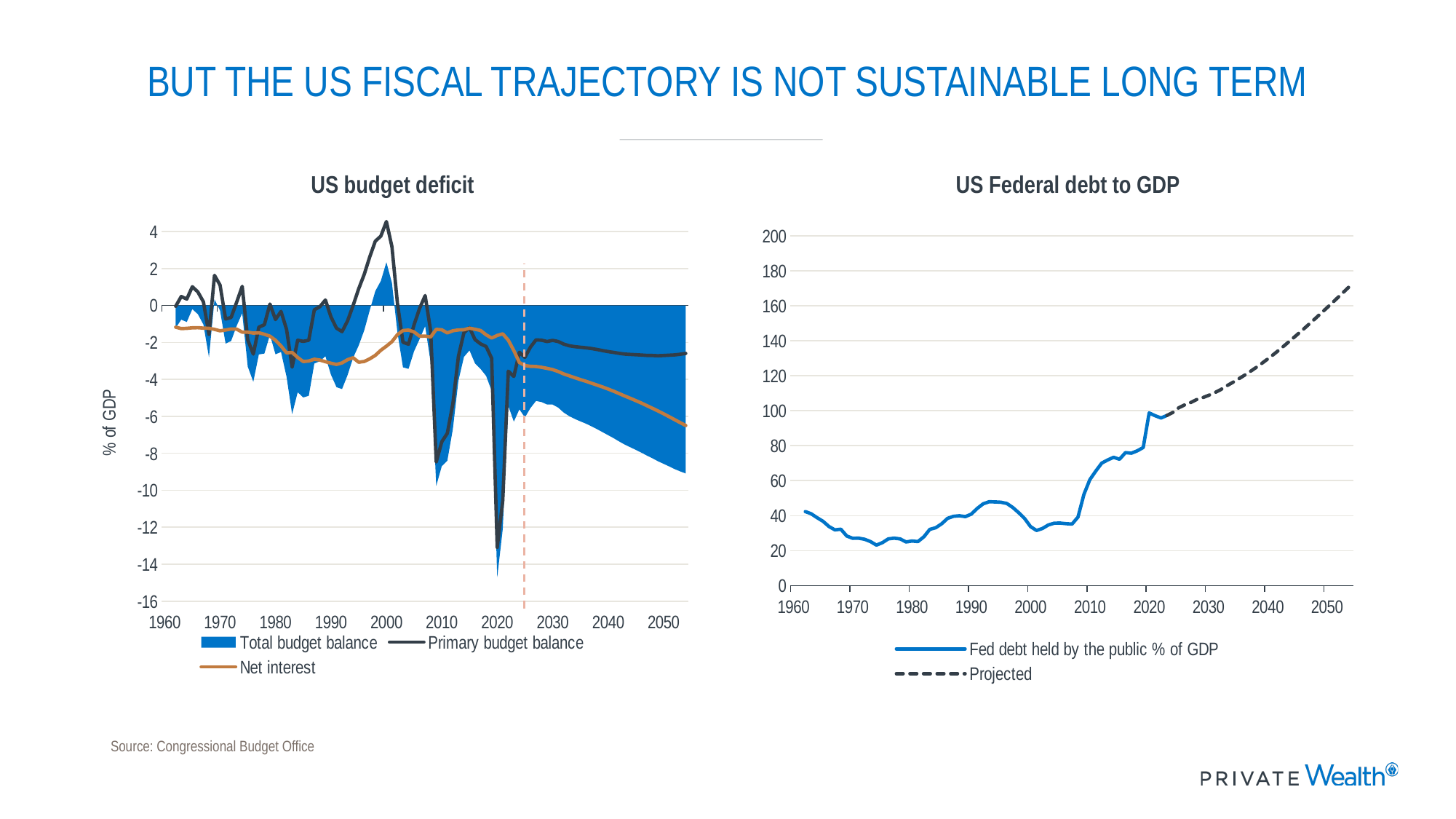
How many series does the legend of the 'US budget deficit' chart list? 3 In the 'US budget deficit' chart, which series is drawn in orange? Net interest In the 'US budget deficit' chart, is the Net interest value at the right end of the chart (around 2050) greater or less than -4? less In the 'US budget deficit' chart, what is the label on the vertical axis? % of GDP In the 'US Federal debt to GDP' chart, is the value around 2020 greater or less than 80? greater What kind of chart is the 'US Federal debt to GDP' chart? line chart In the 'US Federal debt to GDP' chart, does the projected (dashed) line rise or fall from 2025 to 2050? rise In the 'US Federal debt to GDP' chart, is the value around 1975 greater or less than 40? less How many series does the legend of the 'US Federal debt to GDP' chart list? 2